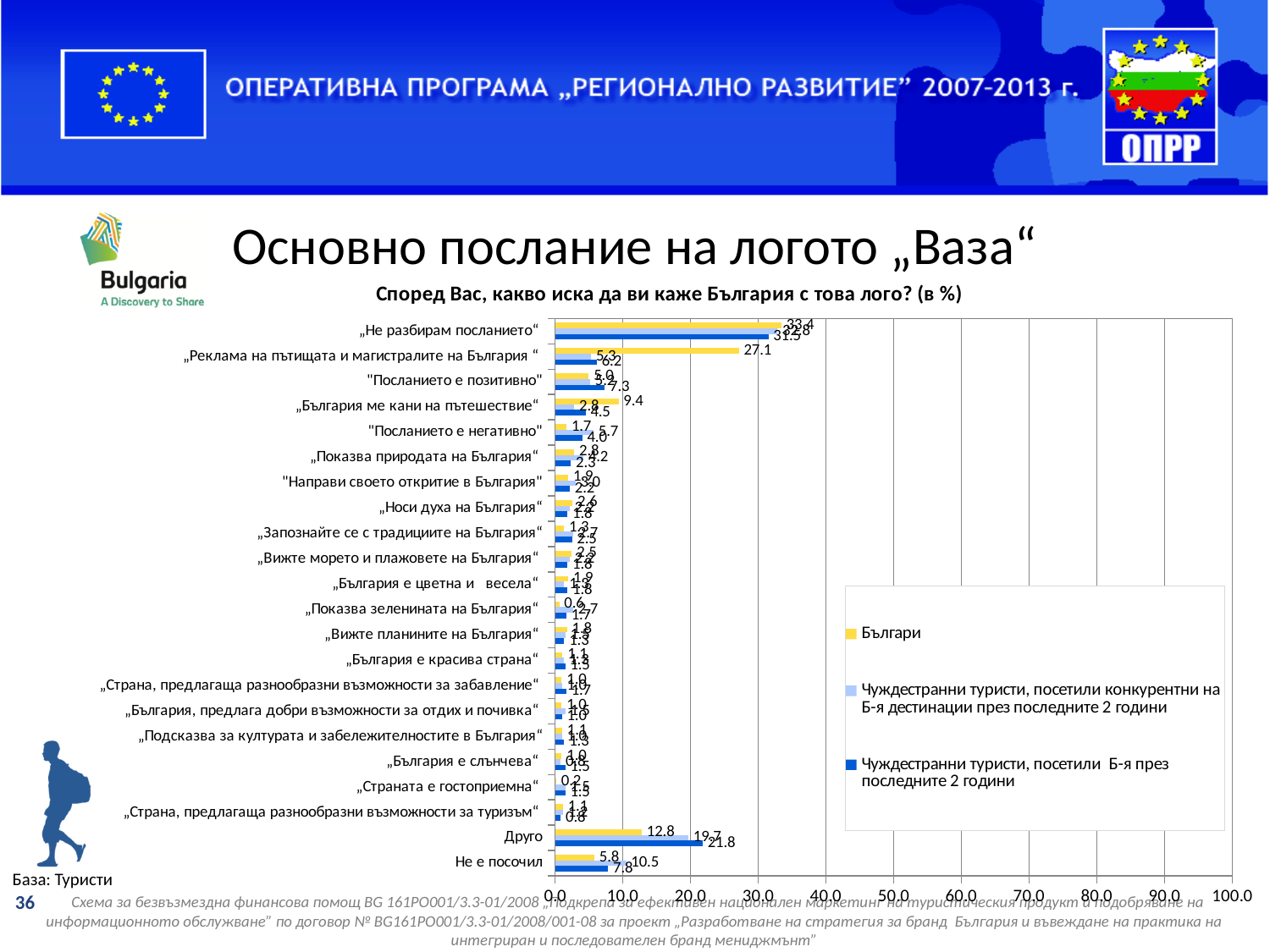
What is the value for "Българи" in the category "Друго"? 12.8 How many categories are plotted on the y axis of the chart? 22 What is the value for "Чуждестранни туристи, посетили Б-я през последните 2 години" in the category "Друго"? 21.8 What is the title of the chart? Според Вас, какво иска да ви каже България с това лого? (в %) What is the value for "Българи" in the category "Реклама на пътищата и магистралите на България"? 27.1 What kind of chart is shown on the slide? bar chart For the category "Друго", which series has the larger value: "Българи" or "Чуждестранни туристи, посетили Б-я през последните 2 години"? Чуждестранни туристи, посетили Б-я през последните 2 години Which category has the highest value for the "Българи" series? „Не разбирам посланието“ How many series does the legend list? 3 What is the difference between the "Българи" values for "Реклама на пътищата и магистралите на България" and "Друго"? 14.3 Is the value for "Българи" in the category "Не разбирам посланието" greater or less than 30.0? greater What is the value for "Българи" in the category "България ме кани на пътешествие"? 9.4